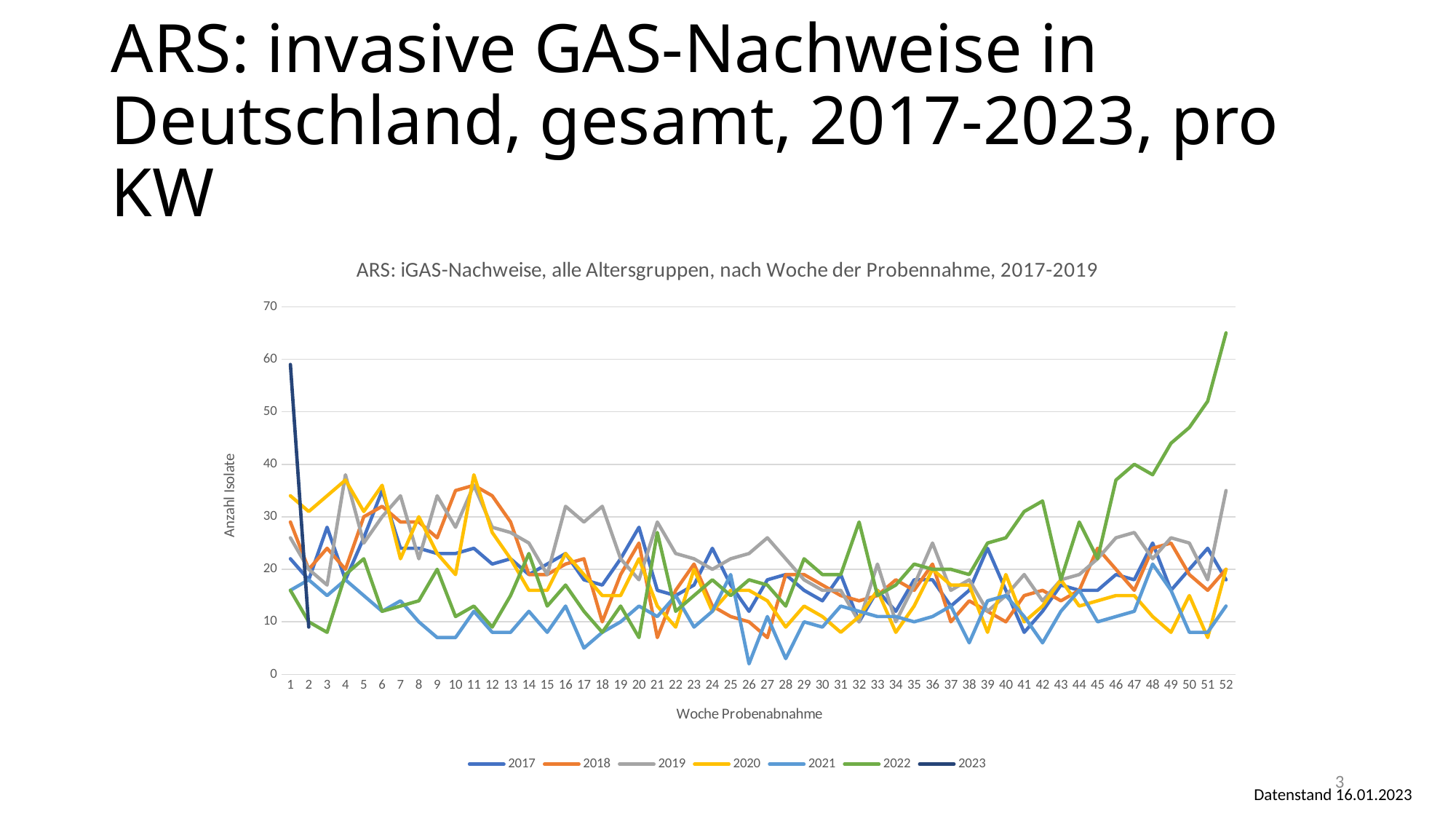
Is the value for 2021 in week 26 greater or less than 10? less Is the value for 2022 in week 52 greater or less than 60? greater Which series has the highest value in week 1? 2023 Does the 2022 series rise or fall from week 40 to week 52? rise Which series has the highest value in week 52? 2022 How many series does the chart legend list? 7 How many weeks are shown along the x axis of the chart? 52 What is the label of the y axis of the chart? Anzahl Isolate Is the value for 2022 in week 47 greater or less than 30? greater What is the title of the chart? ARS: iGAS-Nachweise, alle Altersgruppen, nach Woche der Probennahme, 2017-2019 What kind of chart is shown on the slide? line chart